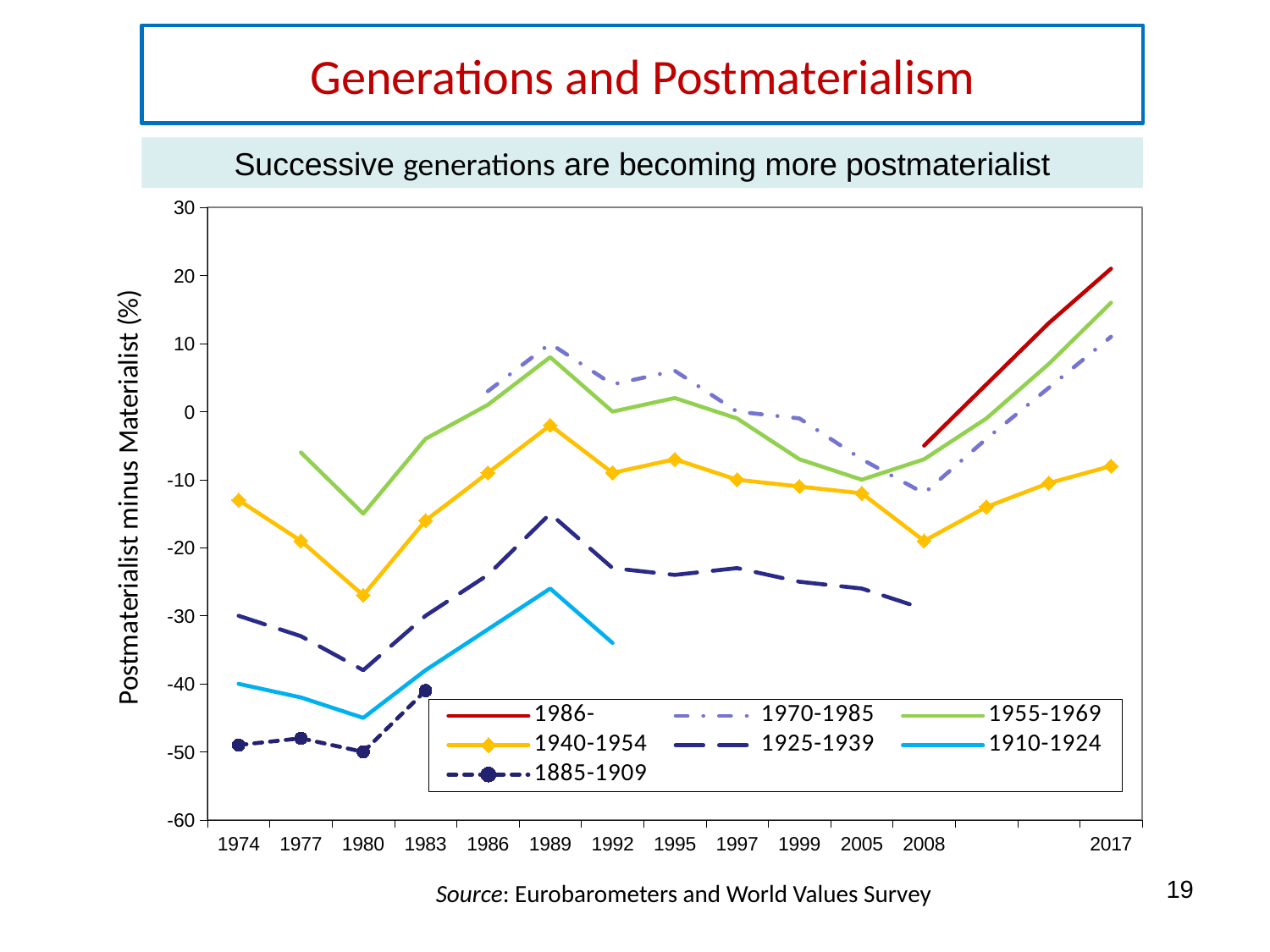
Is the value for the 1940-1954 generation in 1980 greater or less than -20? less Is the value for the 1986- generation in 2017 greater or less than 10? greater In 1989, which is higher: the 1955-1969 generation or the 1940-1954 generation? 1955-1969 How many series does the legend list? 7 Is the value for the 1885-1909 generation in 1974 greater or less than -40? less Which generation has the highest value in 2017? 1986- Does the 1940-1954 line rise or fall between 2008 and 2017? rise What is the label on the vertical axis? Postmaterialist minus Materialist (%) Which generation has the lowest value in 1974? 1885-1909 What is the title of the chart? Generations and Postmaterialism What kind of chart is shown on the slide? line chart